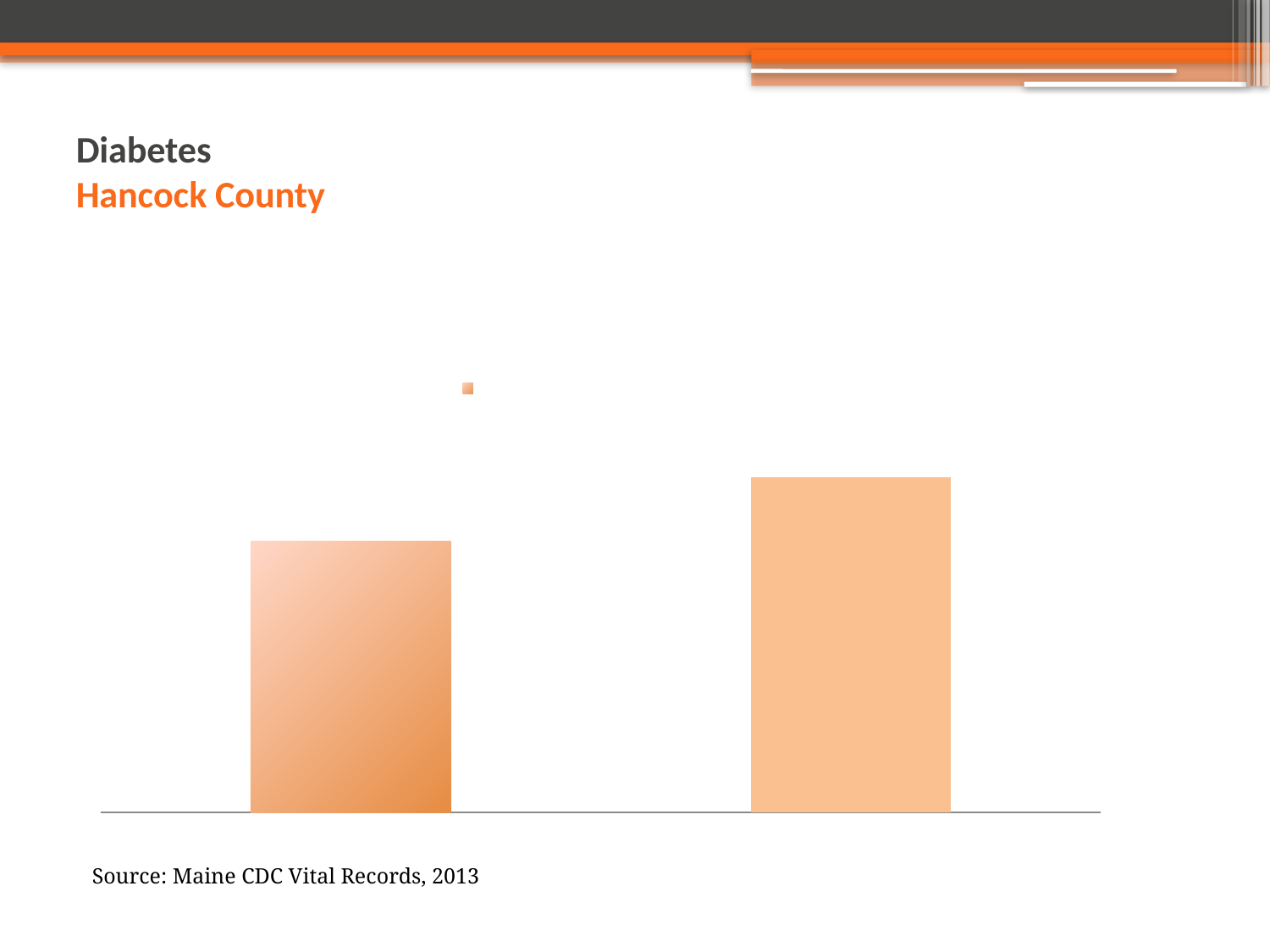
Do the bar values rise or fall from left to right across the chart? rise What is the title of the slide containing the chart? Diabetes Hancock County How many bars are plotted in the chart? 2 Which bar represents the highest value in the chart? the right bar What kind of chart is shown on the slide? bar chart Which bar represents the lowest value in the chart? the left bar What source is cited below the chart? Maine CDC Vital Records, 2013 Which bar is taller, the left bar or the right bar? the right bar How many legend markers are shown above the chart? 1